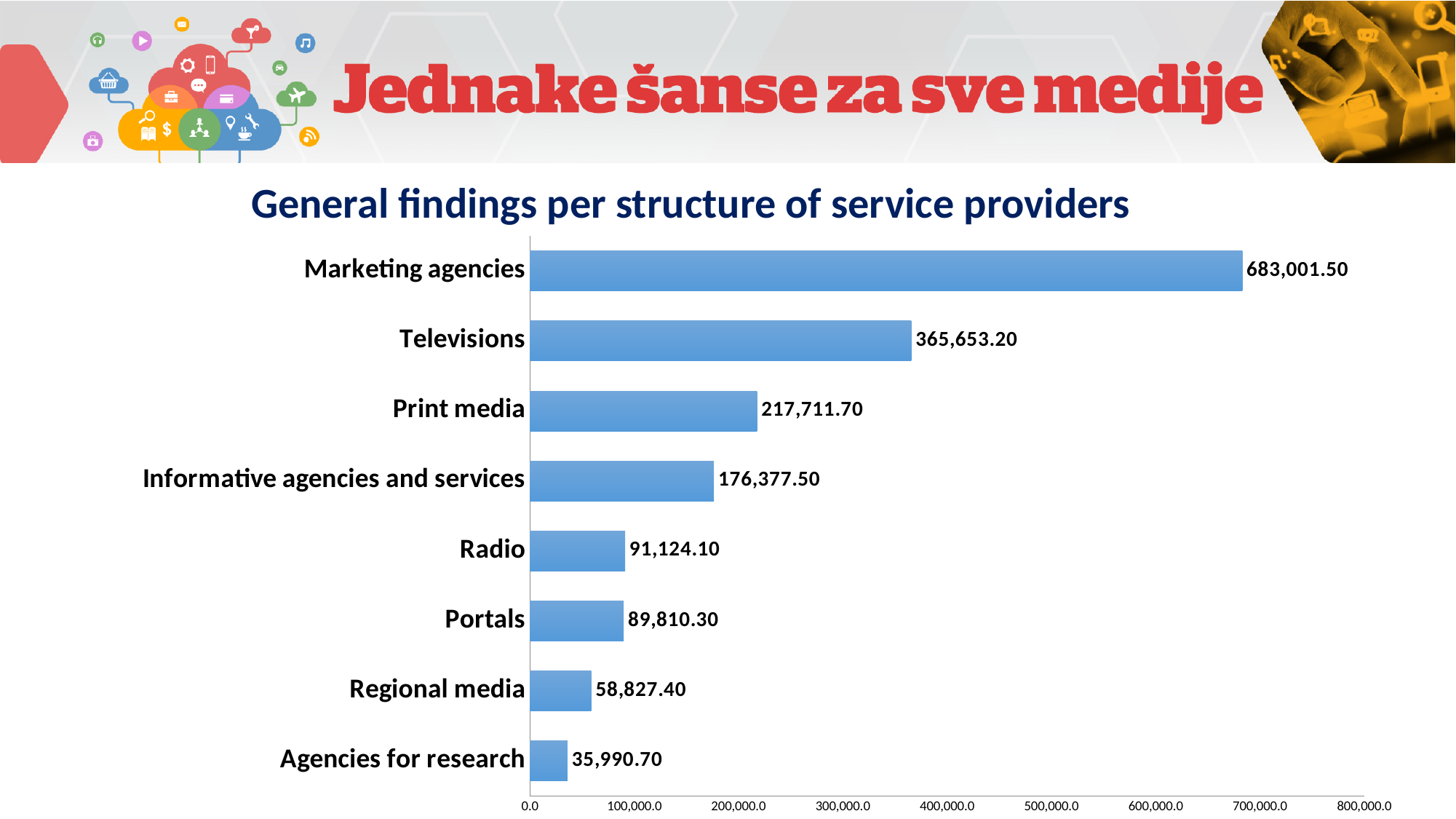
What is the difference between the values for Print media and Informative agencies and services? 41,334.20 What is the value for Regional media? 58,827.40 How many categories are shown in the chart? 8 What is the value for Informative agencies and services? 176,377.50 Which category has the lowest value? Agencies for research What kind of chart is shown on the slide? Bar chart Which category has the highest value? Marketing agencies What is the difference between the values for Marketing agencies and Televisions? 317,348.30 Which has a larger value, Radio or Portals? Radio What is the value for Marketing agencies? 683,001.50 What is the title of the chart? General findings per structure of service providers Is the value for Televisions greater or less than 300,000.0? greater